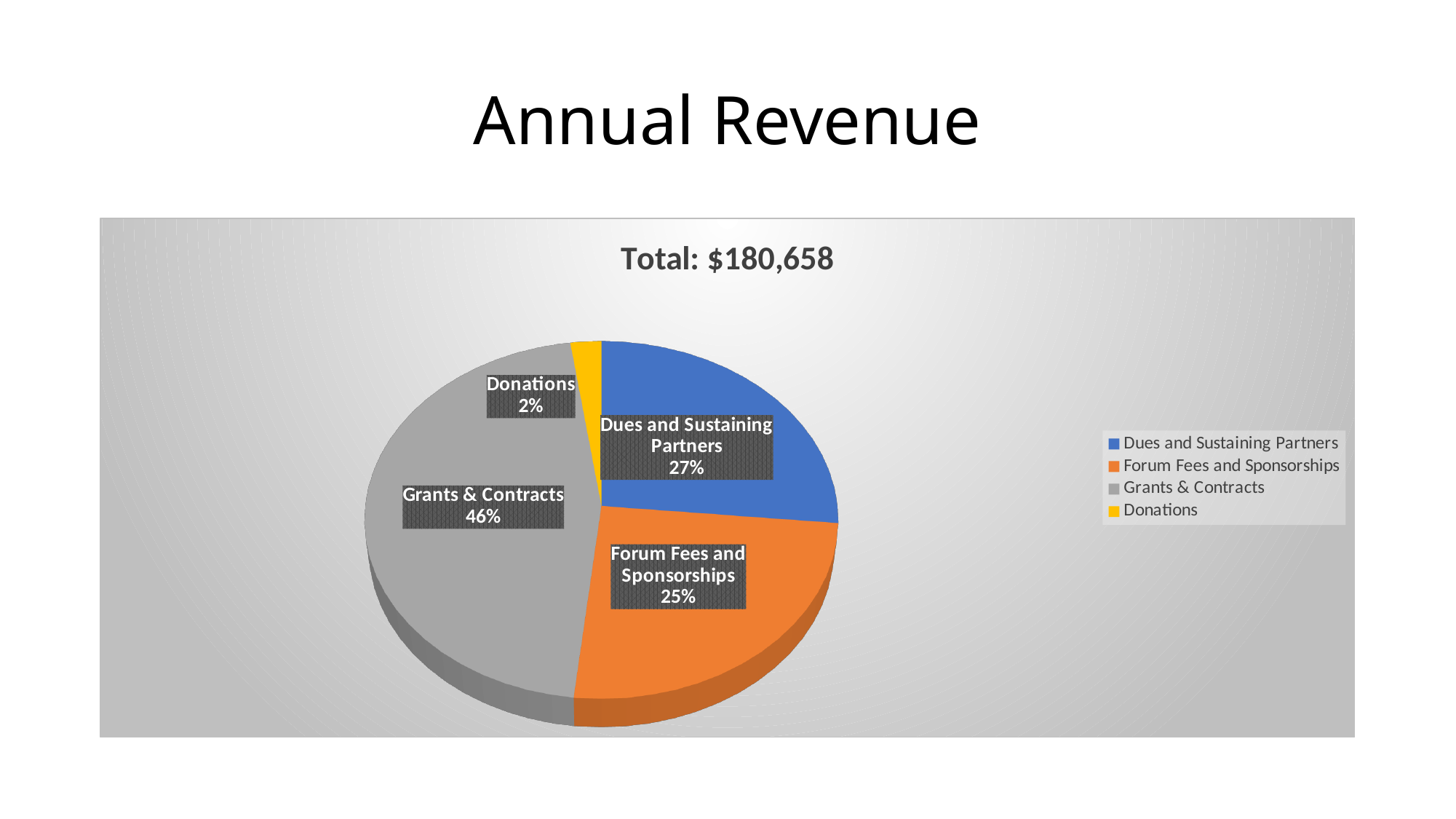
What share of the pie does Donations represent? 2% Which category has the smallest slice of the pie? Donations Which is larger, Dues and Sustaining Partners or Forum Fees and Sponsorships? Dues and Sustaining Partners What share of the pie does Forum Fees and Sponsorships represent? 25% What share of the pie does Dues and Sustaining Partners represent? 27% What kind of chart is shown on the slide? Pie chart What is the chart's title? Total: $180,658 How many categories are shown in the pie chart? 4 What is the difference in percentage points between Grants & Contracts and Forum Fees and Sponsorships? 21 Which colour represents Donations in the pie chart? Yellow Which category has the largest slice of the pie? Grants & Contracts